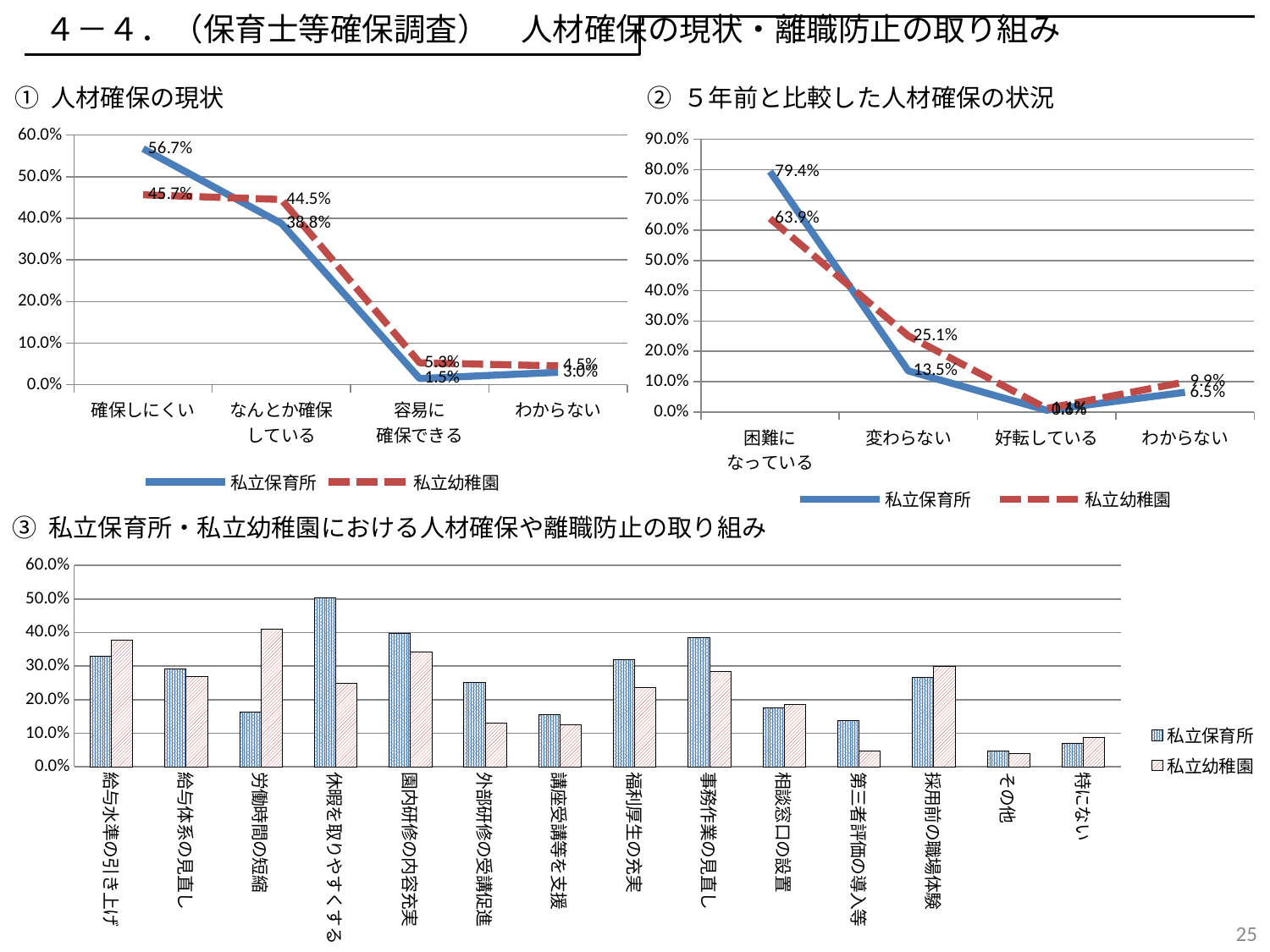
In chart ① 人材確保の現状, what is the value for 私立保育所 at 確保しにくい? 56.7% What kind of chart is chart ③ 私立保育所・私立幼稚園における人材確保や離職防止の取り組み? bar chart In chart ① 人材確保の現状, which series has the higher value at 容易に確保できる? 私立幼稚園 In chart ③, how many categories are shown on the x axis? 14 In chart ② ５年前と比較した人材確保の状況, how many series does the legend list? 2 In chart ① 人材確保の現状, what is the difference between 私立保育所 and 私立幼稚園 at 確保しにくい? 11.0% In chart ③, is the value for 私立幼稚園 at 第三者評価の導入等 greater or less than 10.0%? less In chart ② ５年前と比較した人材確保の状況, which category has the highest value for 私立幼稚園? 困難になっている In chart ② ５年前と比較した人材確保の状況, what is the value for 私立保育所 at 困難になっている? 79.4% In chart ① 人材確保の現状, what is the value for 私立幼稚園 at なんとか確保している? 44.5% In chart ② ５年前と比較した人材確保の状況, what is the value for 私立幼稚園 at 変わらない? 25.1% In chart ③, which category has the highest value for 私立保育所? 休暇を取りやすくする